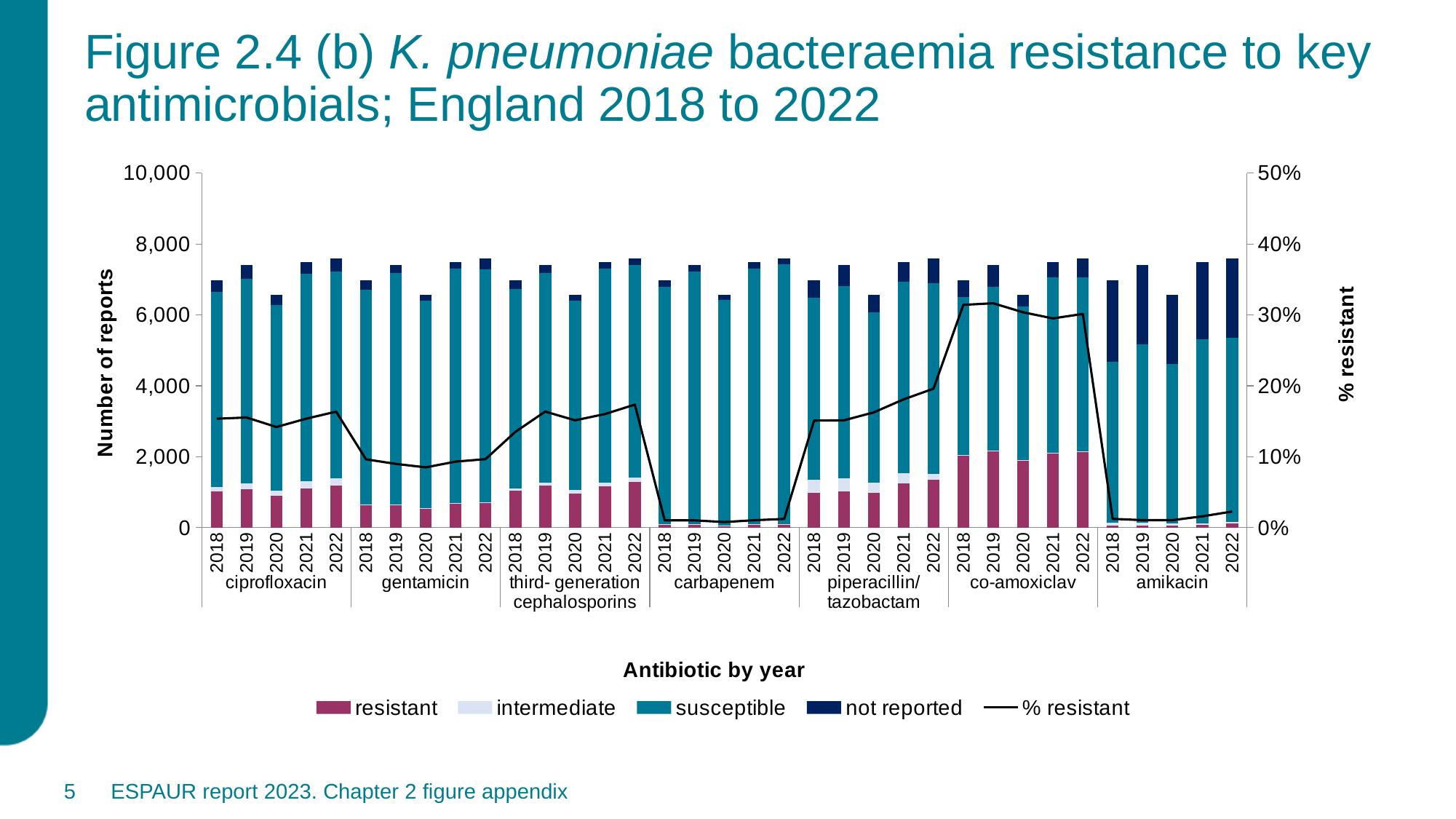
Which is larger: the % resistant for co-amoxiclav in 2022 or for gentamicin in 2022? co-amoxiclav in 2022 How many antibiotic groups are shown along the x axis? 7 How many bars are plotted in total across all antibiotic groups? 35 How many series does the legend list? 5 Is the % resistant value for co-amoxiclav in 2018 greater or less than 20%? greater Is the total number of reports for ciprofloxacin in 2022 greater or less than 6,000? greater Does the % resistant line for piperacillin/tazobactam rise or fall from 2018 to 2022? rise Is the % resistant value for ciprofloxacin in 2018 greater or less than 20%? less What kind of chart is shown on the slide? Stacked bar chart with a line Within the ciprofloxacin group, which year has the lowest total number of reports? 2020 Which antibiotic has the highest % resistant line values? co-amoxiclav